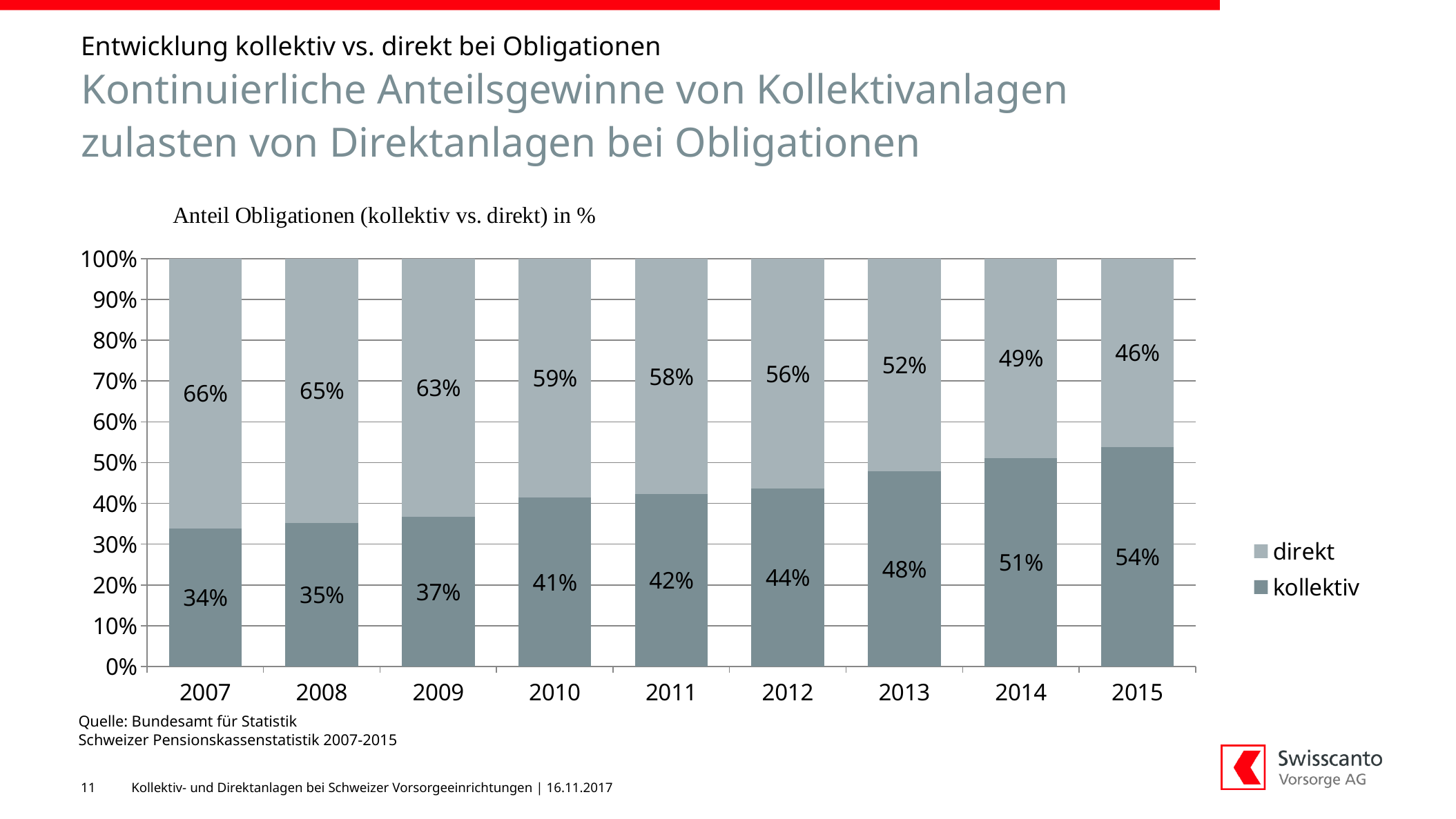
What is the title of the chart? Anteil Obligationen (kollektiv vs. direkt) in % What kind of chart is shown? stacked bar chart Which is larger in 2014, direkt or kollektiv? kollektiv What is the value for direkt in 2015? 46% How many series does the legend list? 2 How many years are shown on the x axis? 9 What is the value for kollektiv in 2012? 44% What is the value for kollektiv in 2007? 34% In which year is the kollektiv share highest? 2015 In which year is the direkt share lowest? 2015 What is the difference between the direkt and kollektiv values in 2010? 18% Does the kollektiv share rise or fall from 2007 to 2015? rise